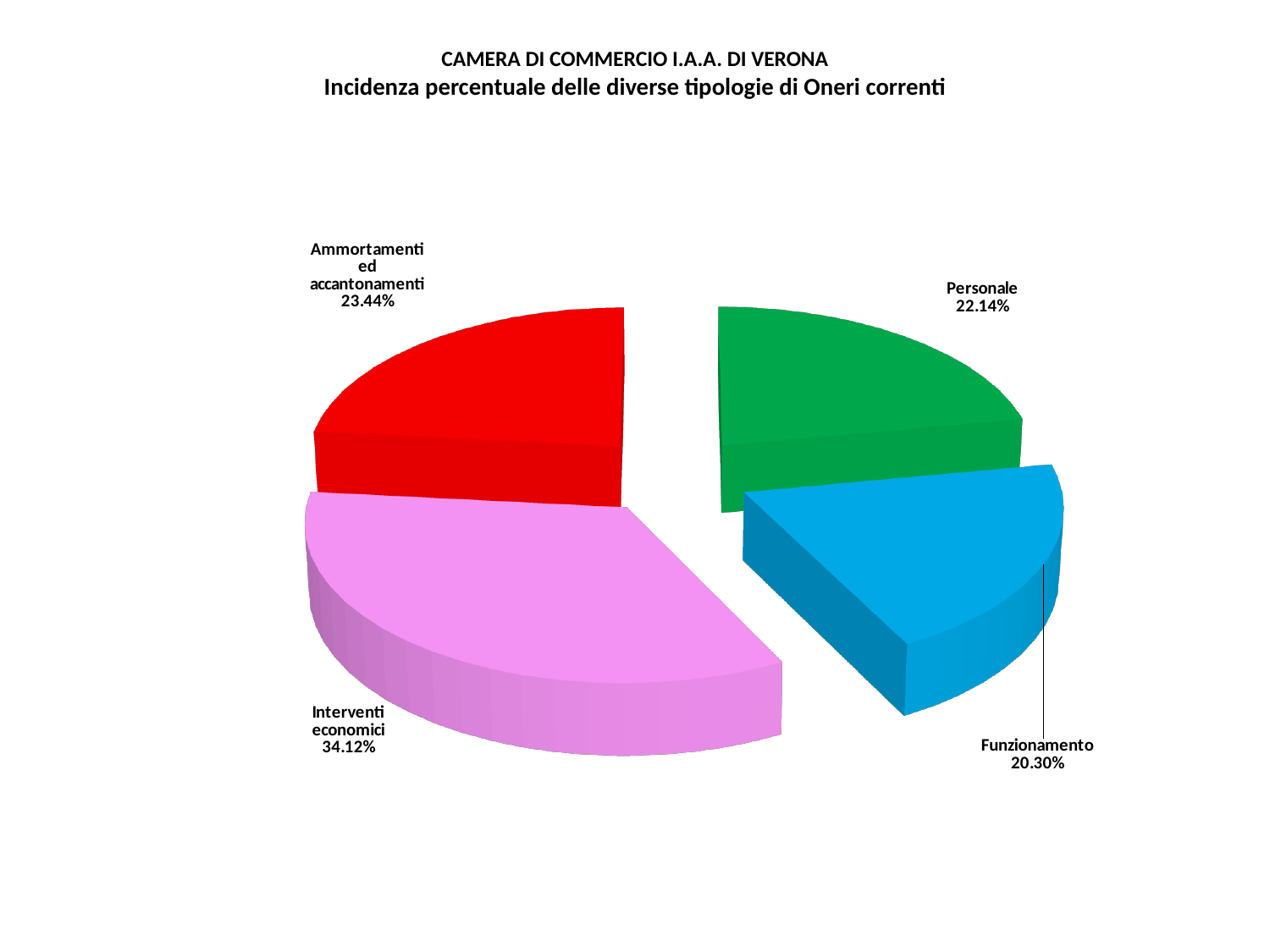
What percentage is shown for Funzionamento? 20.30% What is the value for Ammortamenti ed accantonamenti? 23.44% What kind of chart is shown on the slide? Pie chart What is the difference between the Interventi economici share and the Funzionamento share? 13.82% Which category has the smallest slice of the pie? Funzionamento How many categories are shown in the pie chart? 4 What colour is the Interventi economici slice? Pink What is the difference between Ammortamenti ed accantonamenti and Personale? 1.30% What share of the pie does Interventi economici represent? 34.12% What is the value shown for Personale? 22.14% Which category has the largest slice of the pie? Interventi economici Which is larger, Personale or Funzionamento? Personale